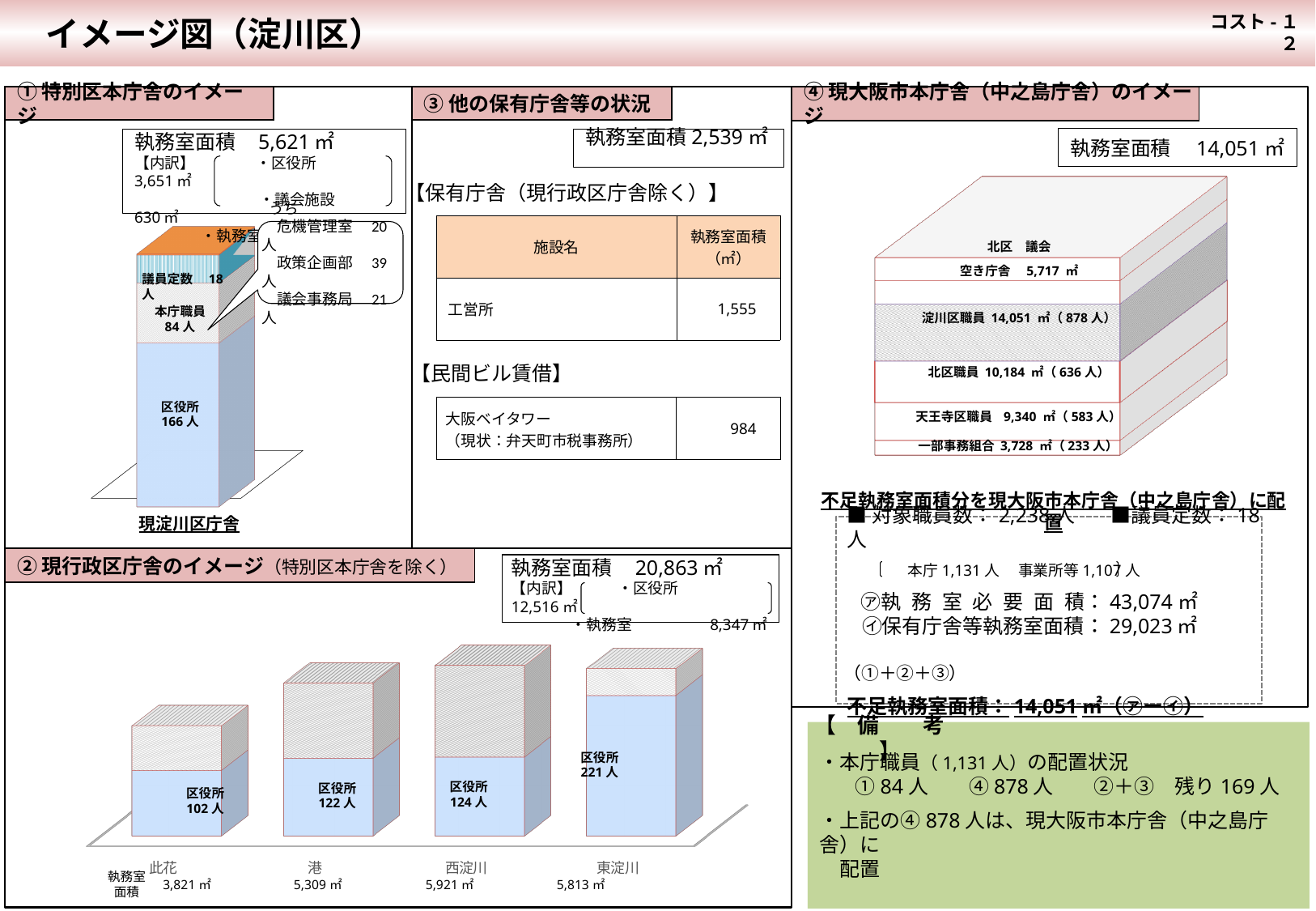
In the ② 現行政区庁舎のイメージ chart at the bottom left, which ward has the smallest 区役所 staff count? 此花 In the ② 現行政区庁舎のイメージ chart at the bottom left, which has more 区役所 staff, 港 or 西淀川? 西淀川 In the ④ 現大阪市本庁舎（中之島庁舎）のイメージ diagram at the top right, how many people are shown for 天王寺区職員? 583 人 In the ④ 現大阪市本庁舎（中之島庁舎）のイメージ diagram at the top right, what is the 執務室面積 shown for 北区職員? 10,184 ㎡ In the ④ 現大阪市本庁舎（中之島庁舎）のイメージ diagram at the top right, what is the difference in area between 淀川区職員 and 一部事務組合? 10,323 ㎡ In the ② 現行政区庁舎のイメージ chart at the bottom left, how many wards are shown? 4 In the ③ 他の保有庁舎等の状況 table, what is the 執務室面積 for 工営所? 1,555 In the ② 現行政区庁舎のイメージ chart at the bottom left, how many 区役所 staff are shown for 東淀川? 221 人 In the ① 特別区本庁舎のイメージ diagram at the top left, how many 区役所 staff are shown in the 現淀川区庁舎 block? 166 人 In the ② 現行政区庁舎のイメージ chart at the bottom left, what is the 執務室面積 for 此花? 3,821 ㎡ In the ② 現行政区庁舎のイメージ chart at the bottom left, which ward has the largest 執務室面積? 西淀川 In the ② 現行政区庁舎のイメージ chart at the bottom left, what is the difference in 執務室面積 between 港 and 此花? 1,488 ㎡